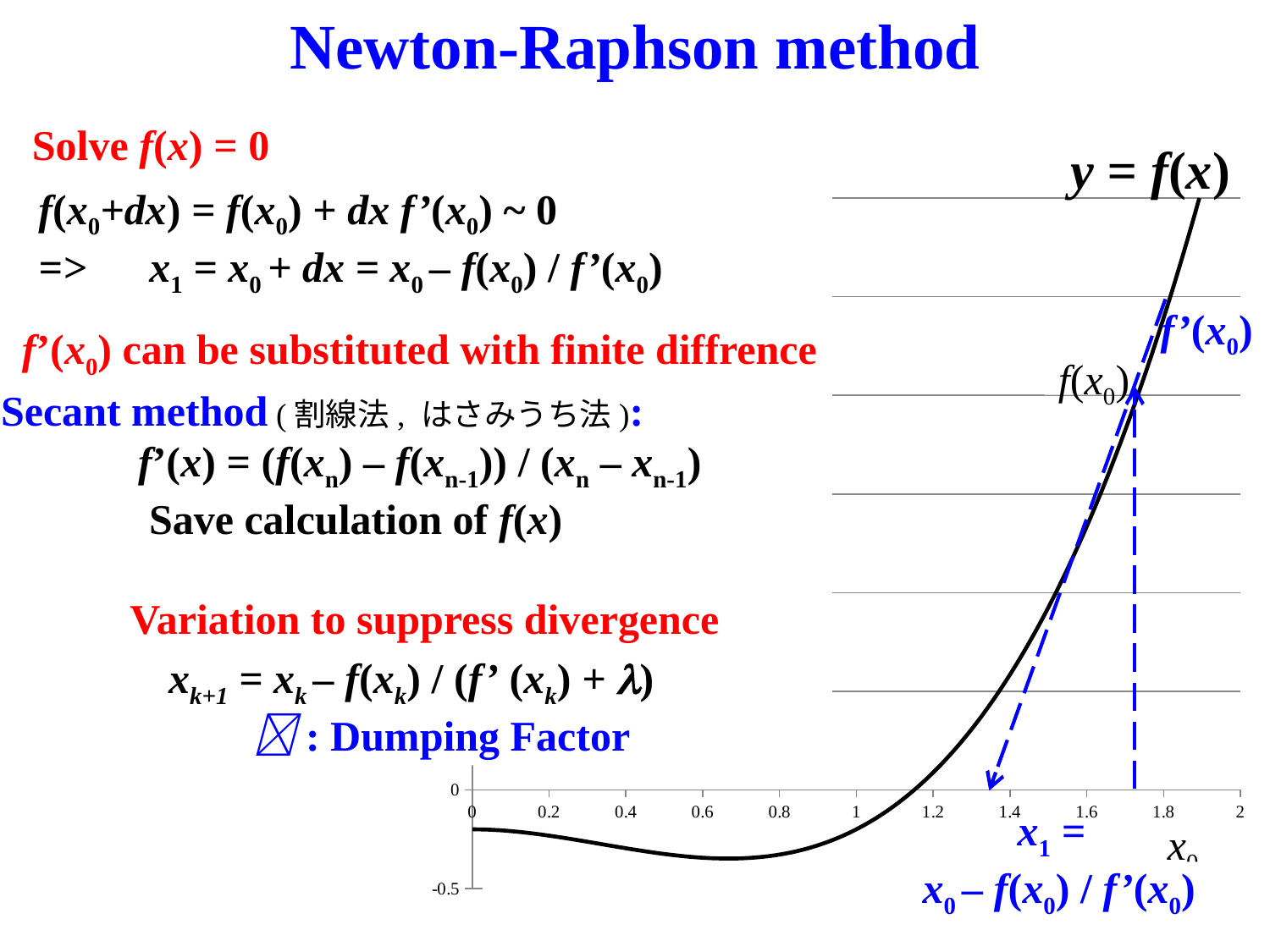
Does the curve y = f(x) rise or fall between x = 1.2 and x = 2? rise What is the largest value labelled on the x axis of the chart? 2 Which is larger, f(x) at x = 0 or f(x) at x = 0.6? f(x) at x = 0 Which is larger, f(x) at x = 1.8 or f(x) at x = 1? f(x) at x = 1.8 Does the curve y = f(x) rise or fall between x = 0 and x = 0.6? fall How many labelled tick marks are on the x axis of the chart? 11 What is the label written above the curve in the chart? y = f(x) Is the value of f(x) at x = 2 greater or less than 0? greater Is the value of f(x) at x = 0.6 greater or less than 0? less What kind of chart is shown on the slide? line chart Is the value of f(x) at x = 0.2 greater or less than -0.5? greater